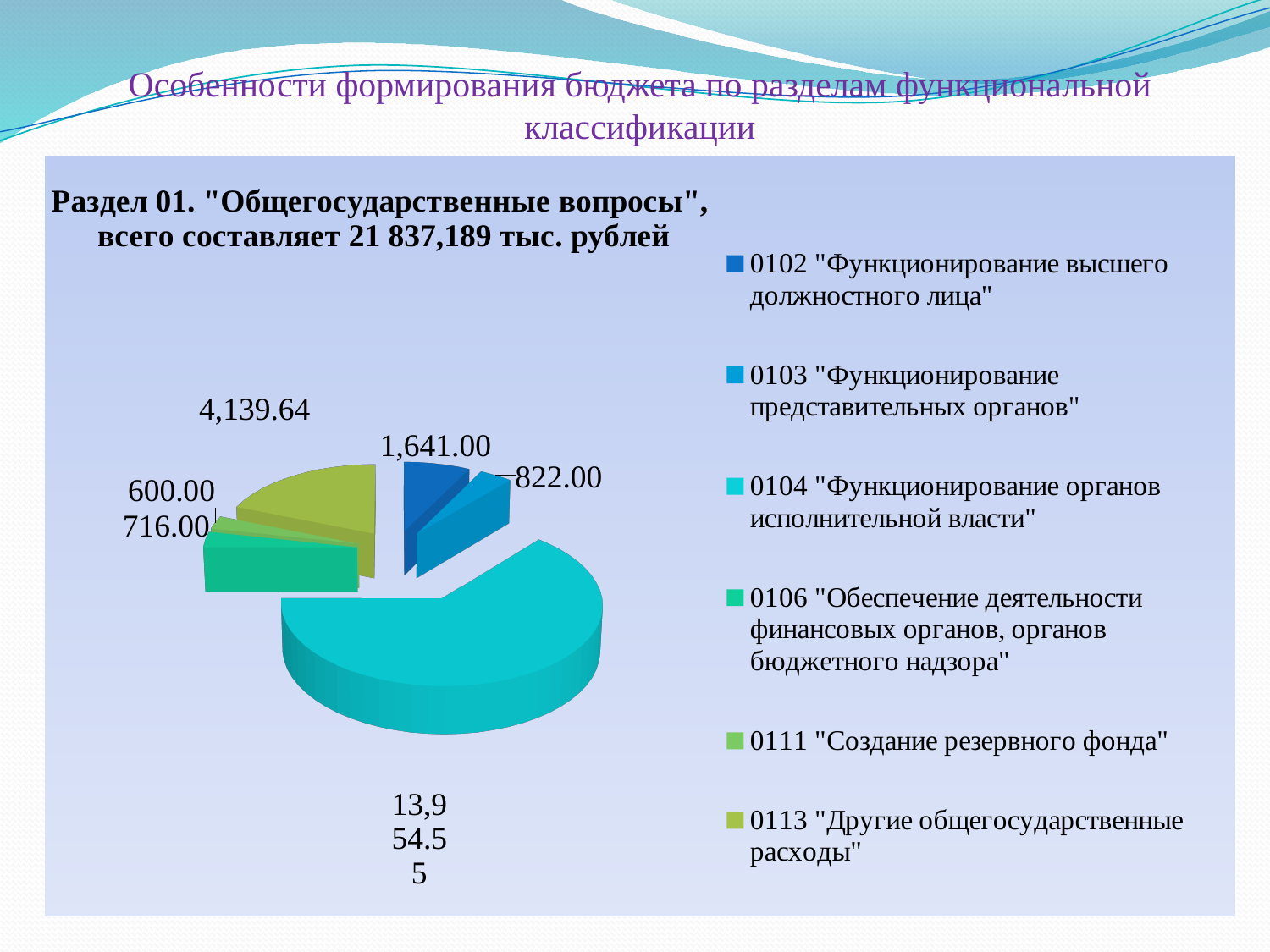
How many slices does the pie chart have? 6 What kind of chart is shown on the slide? pie chart What is the value for 0106 "Обеспечение деятельности финансовых органов, органов бюджетного надзора"? 716.00 Which is larger, the value for 0106 "Обеспечение деятельности финансовых органов, органов бюджетного надзора" or for 0111 "Создание резервного фонда"? 0106 "Обеспечение деятельности финансовых органов, органов бюджетного надзора" What is the value for 0102 "Функционирование высшего должностного лица"? 1,641.00 How many entries does the legend of the pie chart list? 6 What is the difference between the values for 0113 "Другие общегосударственные расходы" and 0102 "Функционирование высшего должностного лица"? 2,498.64 Which category has the largest slice of the pie? 0104 "Функционирование органов исполнительной власти" Which category has the smallest slice of the pie? 0111 "Создание резервного фонда" What is the value for 0103 "Функционирование представительных органов"? 822.00 What is the value for 0113 "Другие общегосударственные расходы"? 4,139.64 What is the value for 0111 "Создание резервного фонда"? 600.00